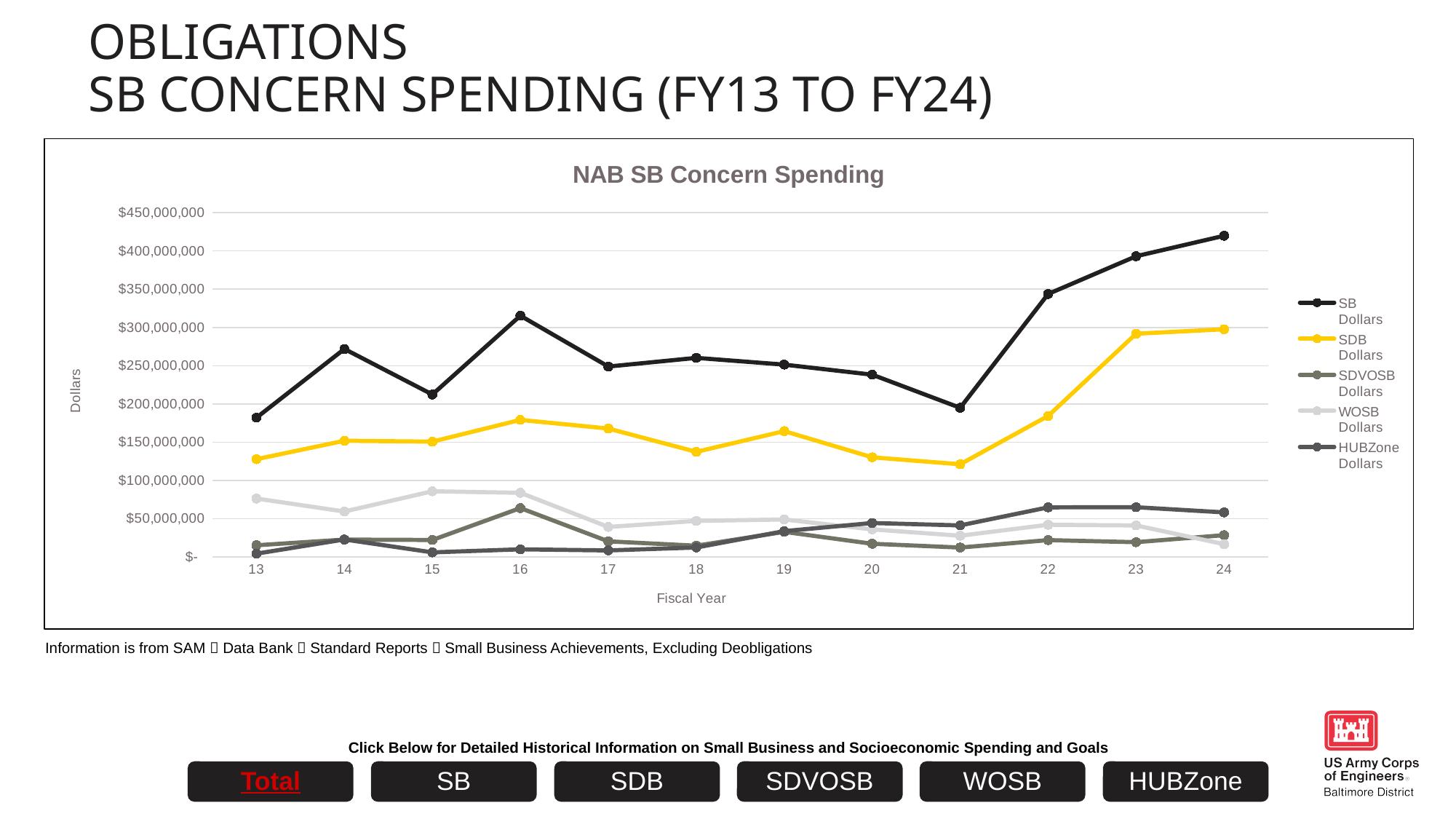
Is the value for SB Dollars in fiscal year 13 greater or less than $200,000,000? less Which is larger for SB Dollars: fiscal year 14 or fiscal year 16? 16 Is the value for SDB Dollars in fiscal year 21 greater or less than $150,000,000? less Is the value for SB Dollars in fiscal year 24 greater or less than $400,000,000? greater What is the title of the chart? NAB SB Concern Spending In which fiscal year is SB Dollars highest? 24 What kind of chart is shown on the slide? line chart How many fiscal years are plotted along the x axis? 12 Do SB Dollars rise or fall from fiscal year 21 to fiscal year 24? rise In which fiscal year is SB Dollars lowest? 13 In fiscal year 24, which is larger: SDB Dollars or WOSB Dollars? SDB Dollars How many series does the legend list? 5